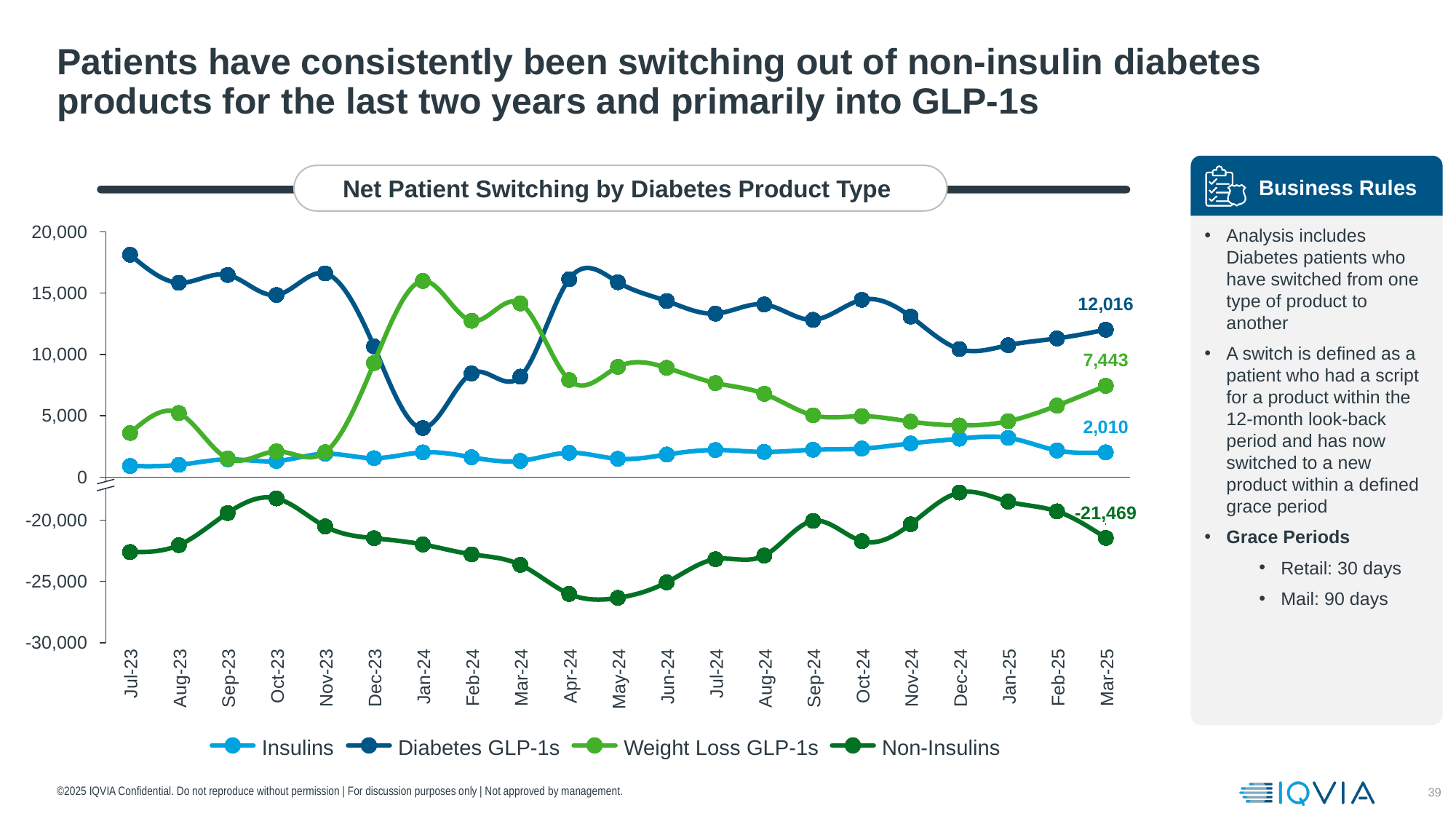
In Mar-25, which is larger: Diabetes GLP-1s or Weight Loss GLP-1s? Diabetes GLP-1s What is the difference between the Mar-25 values for Diabetes GLP-1s and Weight Loss GLP-1s? 4,573 How many series does the legend list? 4 Is the value for Diabetes GLP-1s in Jul-23 greater or less than 15,000? greater Is the value for Non-Insulins in Apr-24 greater or less than -25,000? less What kind of chart is shown on the slide? line chart How many months are plotted on the x axis? 21 What is the value for Weight Loss GLP-1s in Mar-25? 7,443 What is the value for Insulins in Mar-25? 2,010 Which series has the highest value in Jul-23? Diabetes GLP-1s What is the value for Non-Insulins in Mar-25? -21,469 What is the value for Diabetes GLP-1s in Mar-25? 12,016